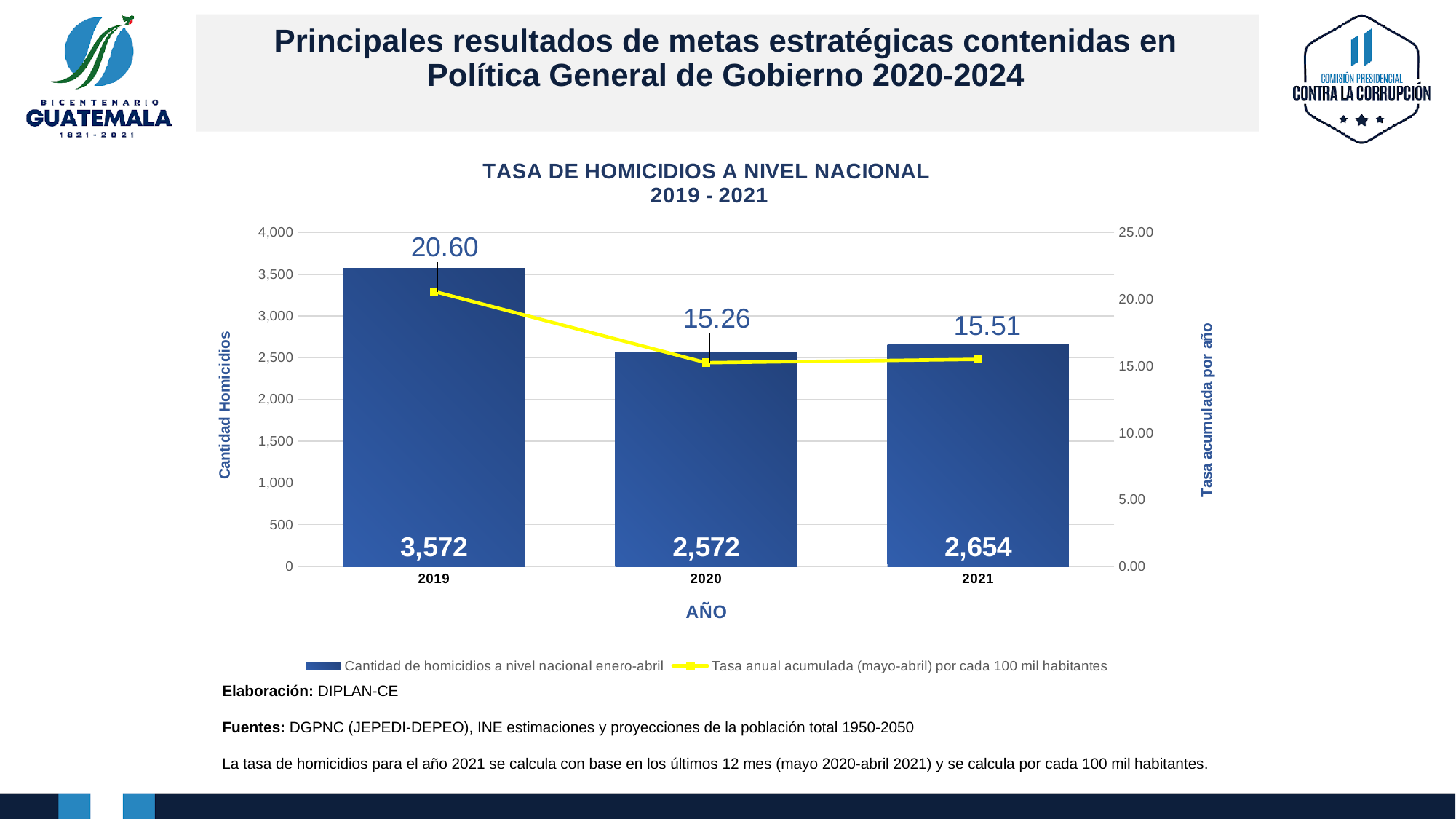
Which year has the lowest homicide rate? 2020 Which year has the highest number of homicides? 2019 What is the difference in the homicide rate between 2020 and 2021? 0.25 Which year has more homicides, 2020 or 2021? 2021 How many series does the legend list? 2 What is the title of the chart? TASA DE HOMICIDIOS A NIVEL NACIONAL 2019 - 2021 What is the homicide rate shown for 2019? 20.60 What is the homicide rate (Tasa anual acumulada) shown for 2021? 15.51 What is the number of homicides (Cantidad de homicidios) shown for 2019? 3,572 How many years are shown on the x axis? 3 What is the number of homicides shown for 2020? 2,572 What is the difference in the number of homicides between 2019 and 2020? 1,000